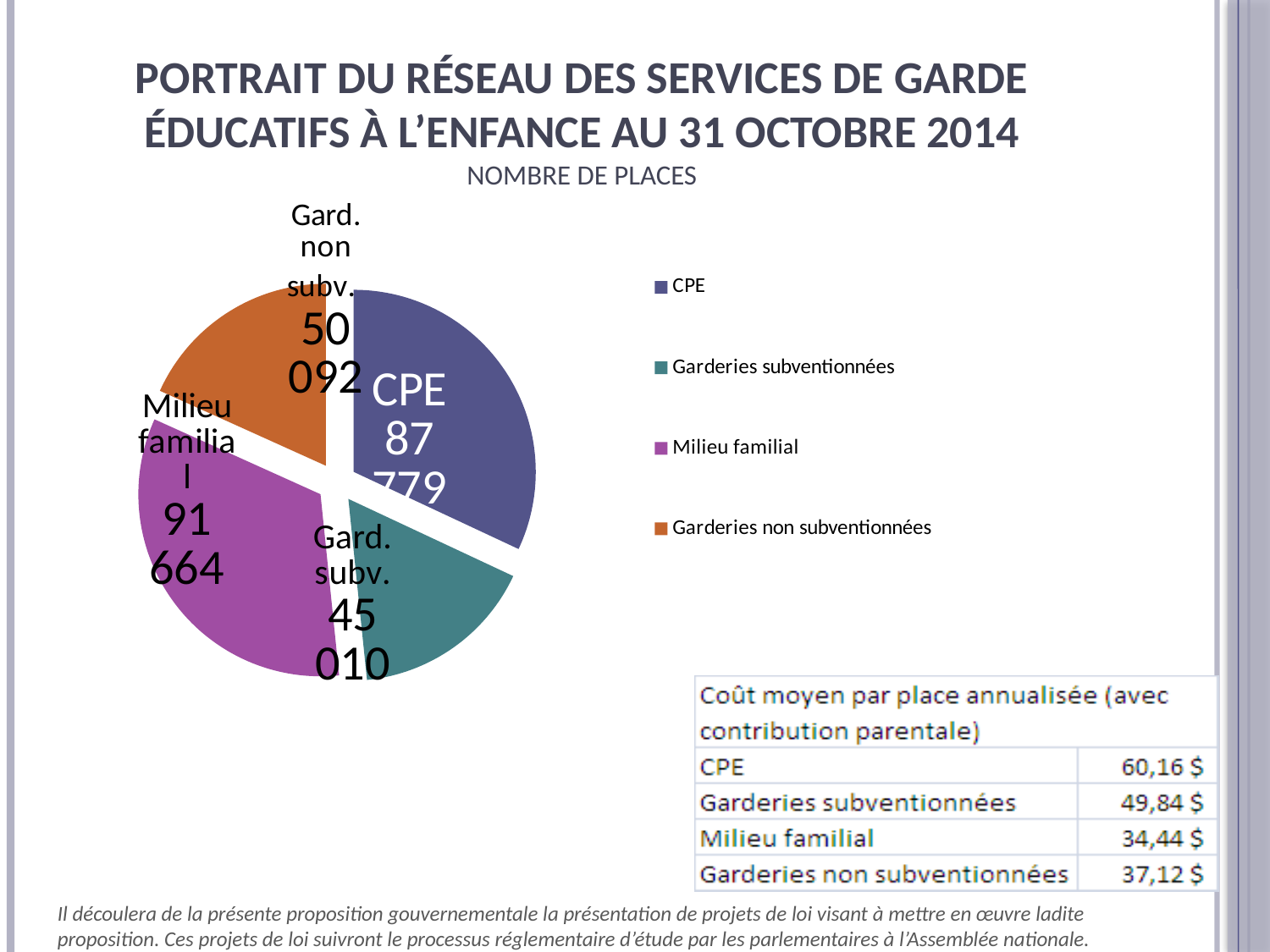
What is the number of places for Gard. non subv. (Garderies non subventionnées) in the pie chart? 50 092 What is the number of places for Milieu familial in the pie chart? 91 664 Which has more places, CPE or Garderies subventionnées? CPE How many entries does the legend of the pie chart list? 4 What type of chart is shown on the slide? pie chart Which category has the smallest number of places in the pie chart? Garderies subventionnées What is the difference in places between Milieu familial and CPE? 3 885 What is the title of the pie chart? NOMBRE DE PLACES What is the number of places for Gard. subv. (Garderies subventionnées) in the pie chart? 45 010 What is the number of places for CPE in the pie chart? 87 779 Which category has the largest number of places in the pie chart? Milieu familial How many slices does the pie chart have? 4